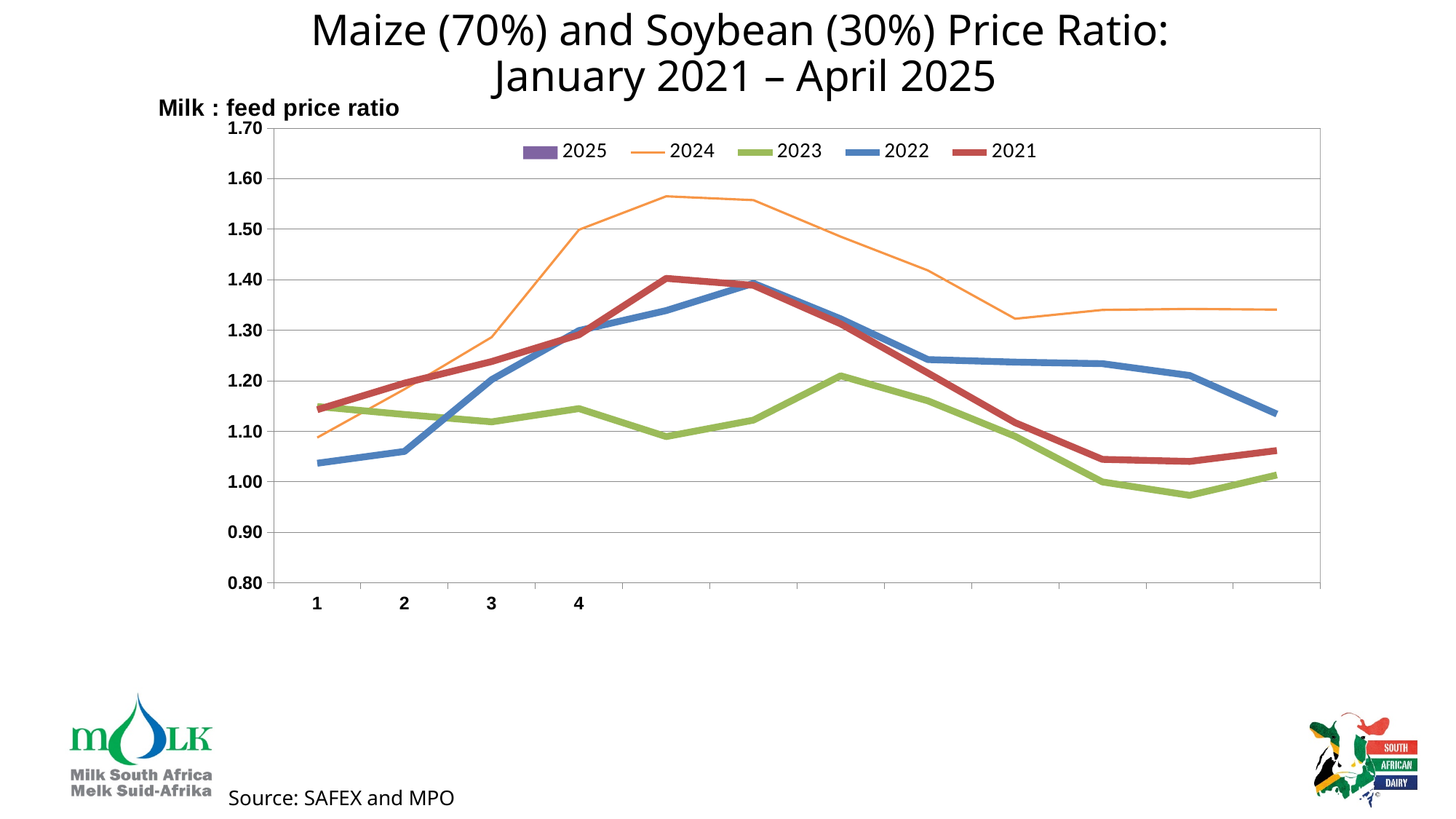
What kind of chart is shown on the slide? line chart Which series reaches the highest milk : feed price ratio on the chart? 2024 Is the value for 2021 at point 10 greater or less than 1.10? less At point 1, which series has the higher value, 2021 or 2022? 2021 How many series does the legend list? 5 At point 12, which series has the higher value, 2022 or 2021? 2022 Is the value for 2023 at point 11 greater or less than 1.00? less Is the value for 2024 at point 5 greater or less than 1.50? greater What is the label shown above the vertical axis of the chart? Milk : feed price ratio Which series drops to the lowest milk : feed price ratio on the chart? 2023 Does the 2024 series rise or fall from point 1 to point 5? rise